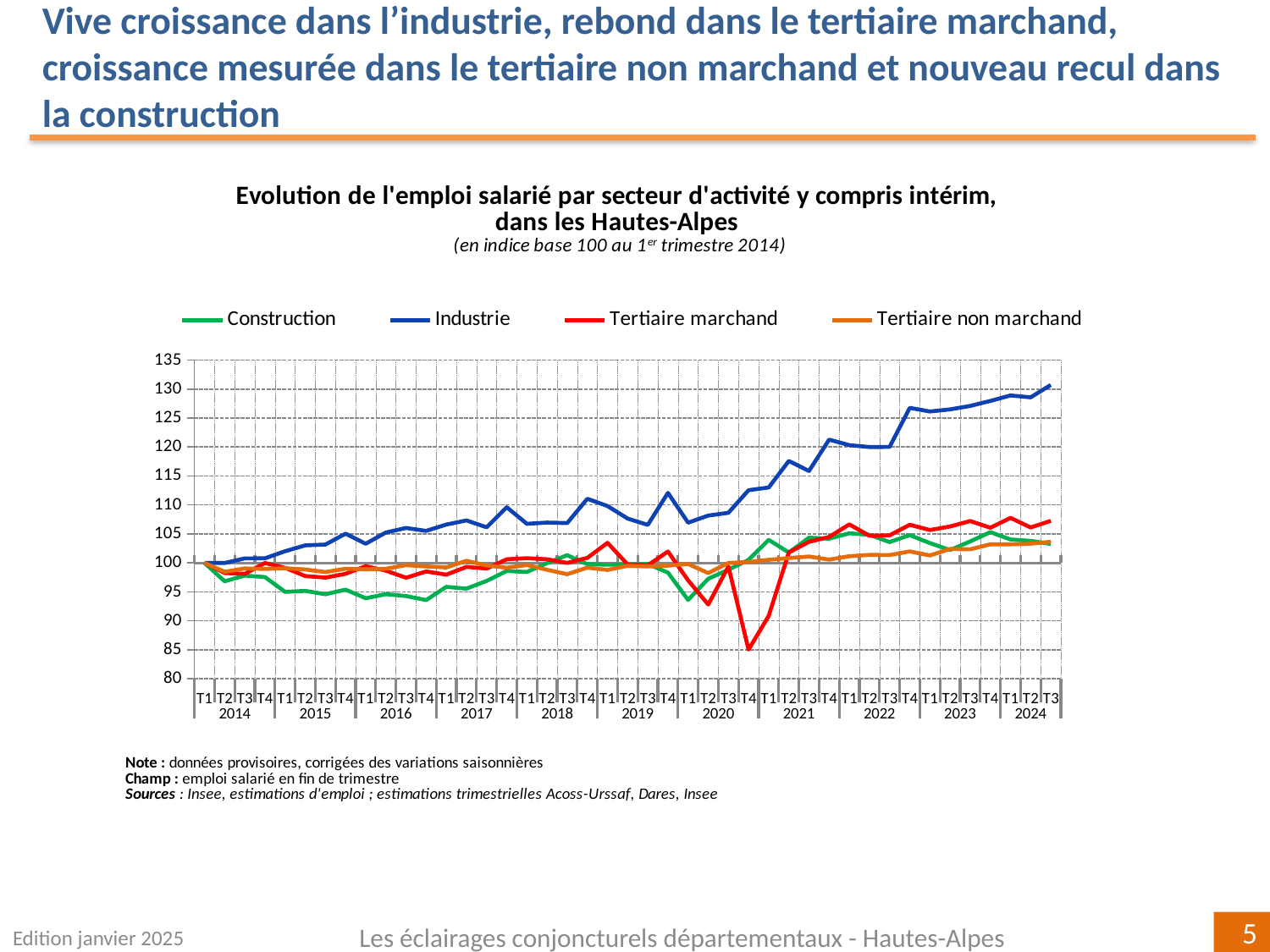
Which series has the highest value at T3 2024? Industrie Is the value for Industrie at T3 2024 greater or less than 125? greater How many series does the legend list? 4 Which series are listed in the legend? Construction, Industrie, Tertiaire marchand, Tertiaire non marchand How many years are shown on the x axis? 11 Does the Industrie series rise or fall overall from T1 2014 to T3 2024? rise Is the value for Construction at T1 2017 greater or less than 100? less What colour is the Industrie line? blue Which series has the lowest value at T4 2020? Tertiaire marchand Is the value for Tertiaire marchand at T4 2020 greater or less than 90? less What kind of chart is shown on the slide? line chart Which is larger at T4 2020, Industrie or Tertiaire marchand? Industrie